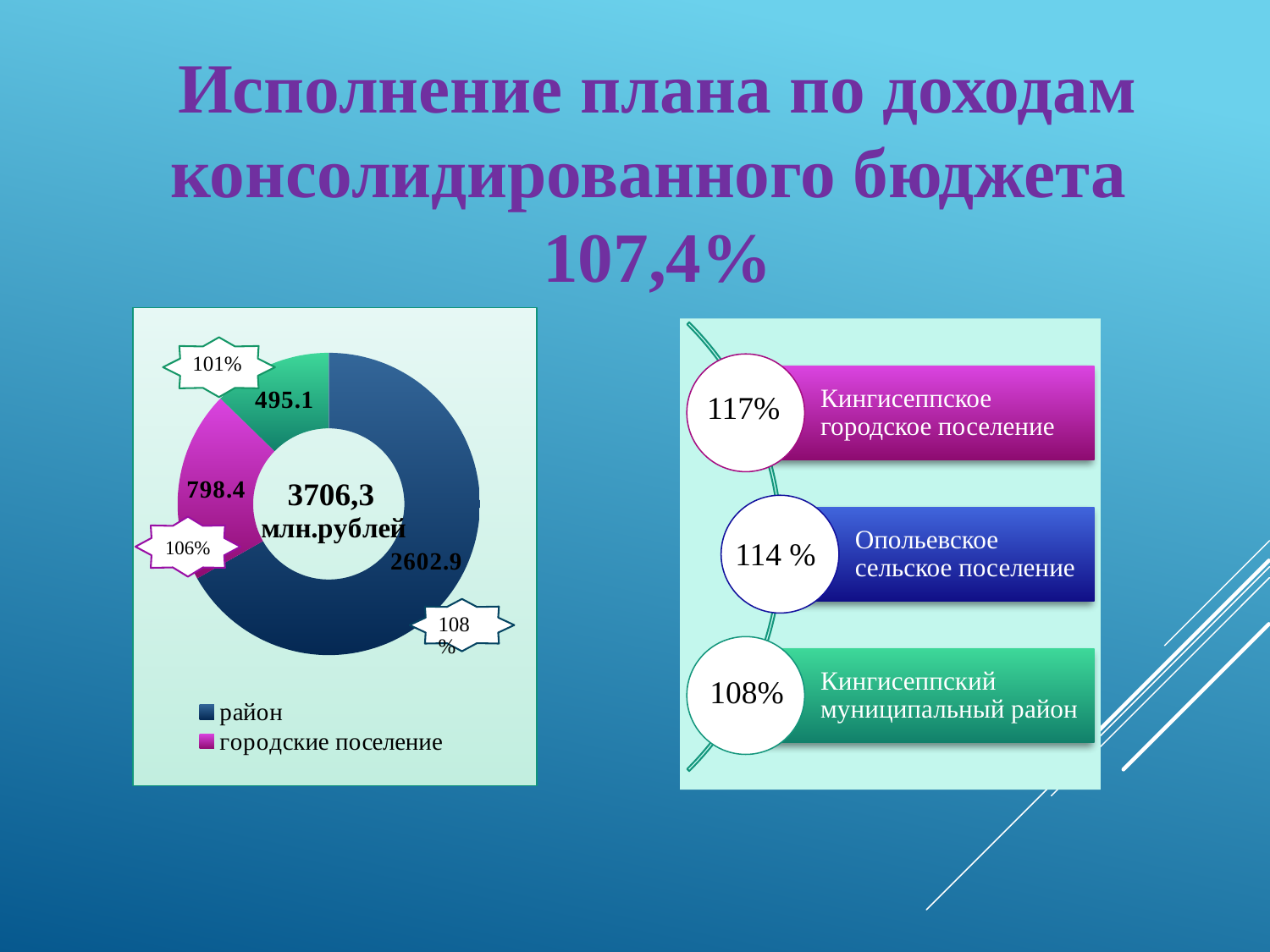
In the doughnut chart, which category has the largest value? район In the doughnut chart, what is the value for городские поселение? 798.4 How many slices does the doughnut chart have? 3 What kind of chart is shown on the left of the slide? doughnut chart What total is printed in the centre of the doughnut chart? 3706,3 млн.рублей In the doughnut chart, what percentage is shown in the callout next to the 2602.9 slice? 108% In the doughnut chart, what is the difference between the values for район and городские поселение? 1804.5 In the doughnut chart, what colour is the район slice? dark blue In the doughnut chart, what is the smallest value labelled on a slice? 495.1 In the doughnut chart, what is the value for район? 2602.9 How many entries does the legend of the doughnut chart list? 2 In the doughnut chart, which is larger: район or городские поселение? район